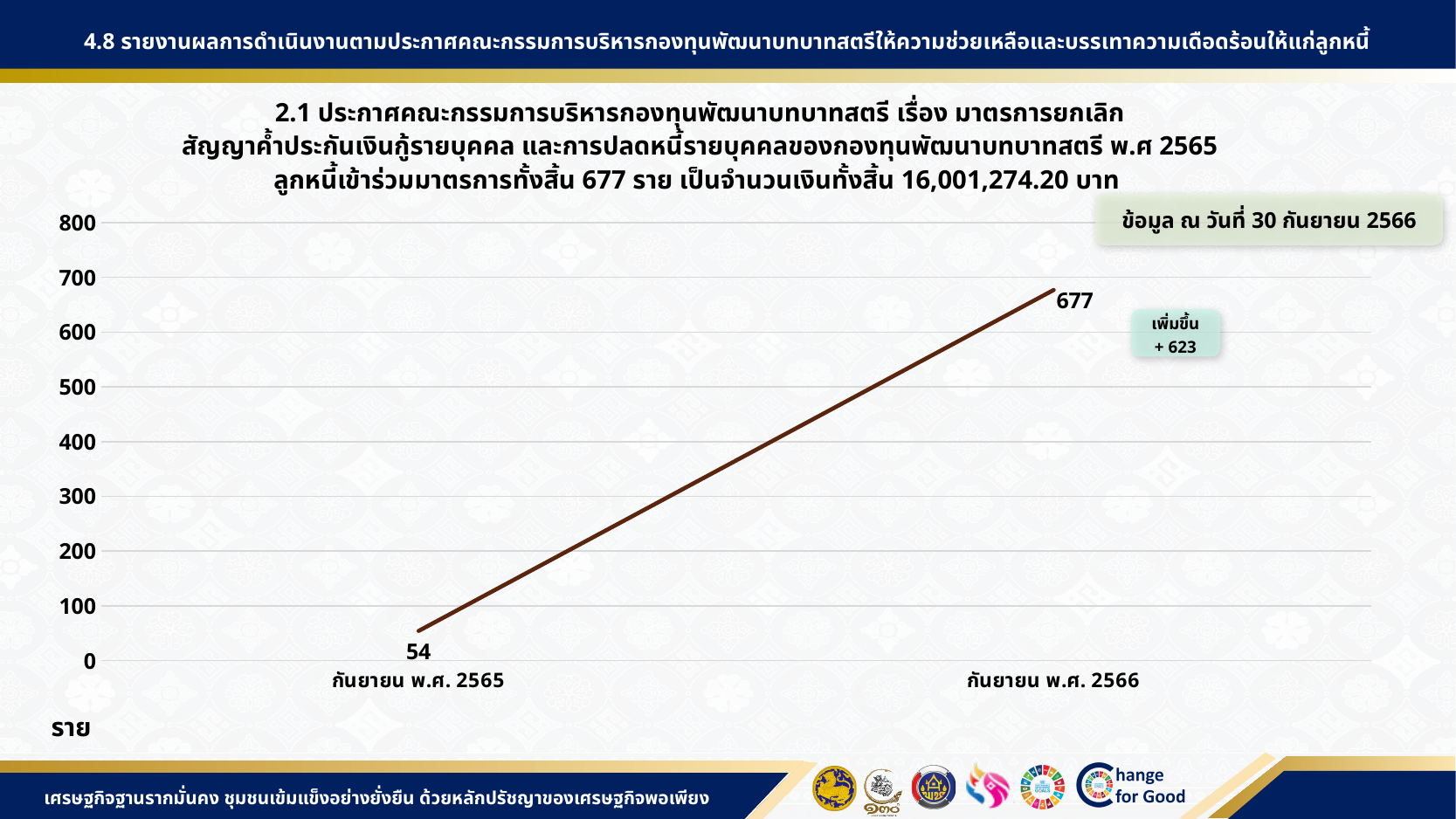
Which point has the highest value? กันยายน พ.ศ. 2566 Which is larger, the value for กันยายน พ.ศ. 2565 or กันยายน พ.ศ. 2566? กันยายน พ.ศ. 2566 What is the value for กันยายน พ.ศ. 2565? 54 What kind of chart is shown on the slide? line chart Is the value for กันยายน พ.ศ. 2565 greater or less than 100? less What is the difference between the values for กันยายน พ.ศ. 2566 and กันยายน พ.ศ. 2565? 623 Is the value for กันยายน พ.ศ. 2566 greater or less than 600? greater How many data points are plotted on the chart? 2 Which point has the lowest value? กันยายน พ.ศ. 2565 What is the value for กันยายน พ.ศ. 2566? 677 Do the values rise or fall from กันยายน พ.ศ. 2565 to กันยายน พ.ศ. 2566? rise What is the highest value shown on the vertical axis? 800